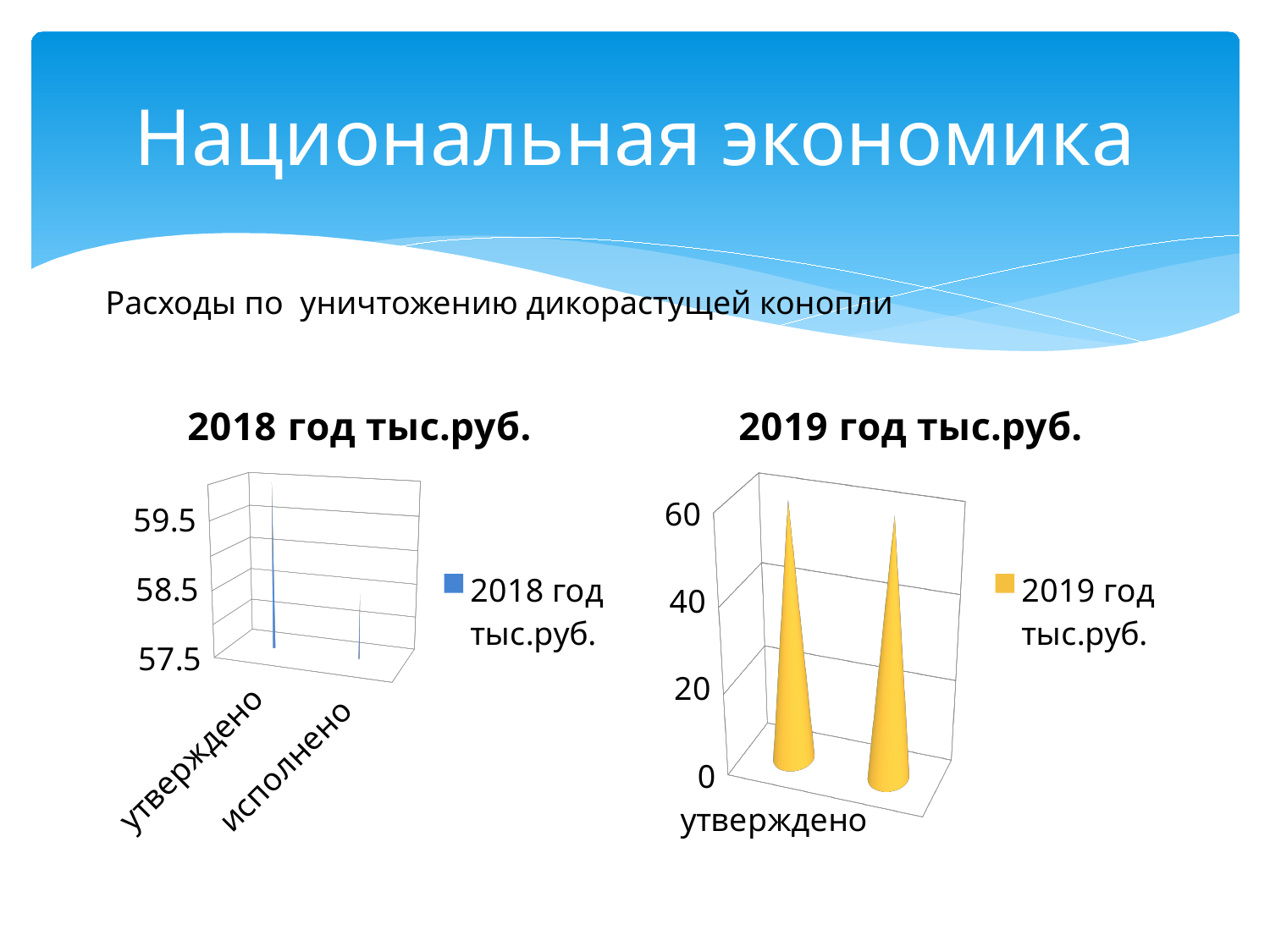
What is the legend entry of the "2019 год тыс.руб." chart? 2019 год тыс.руб. How many bars are plotted in the "2019 год тыс.руб." chart? 2 How many categories are shown on the x axis of the "2018 год тыс.руб." chart? 2 How many series does the legend of the "2019 год тыс.руб." chart list? 1 In the "2018 год тыс.руб." chart, which category has the lowest value? исполнено How many series does the legend of the "2018 год тыс.руб." chart list? 1 In the "2018 год тыс.руб." chart, which category has the higher value, утверждено or исполнено? утверждено What kind of chart is the "2019 год тыс.руб." chart? bar chart What kind of chart is the "2018 год тыс.руб." chart? bar chart In the "2019 год тыс.руб." chart, is the value for утверждено greater or less than 40? greater In the "2018 год тыс.руб." chart, is the value for утверждено greater or less than 59.5? greater What colour are the bars in the "2019 год тыс.руб." chart? yellow